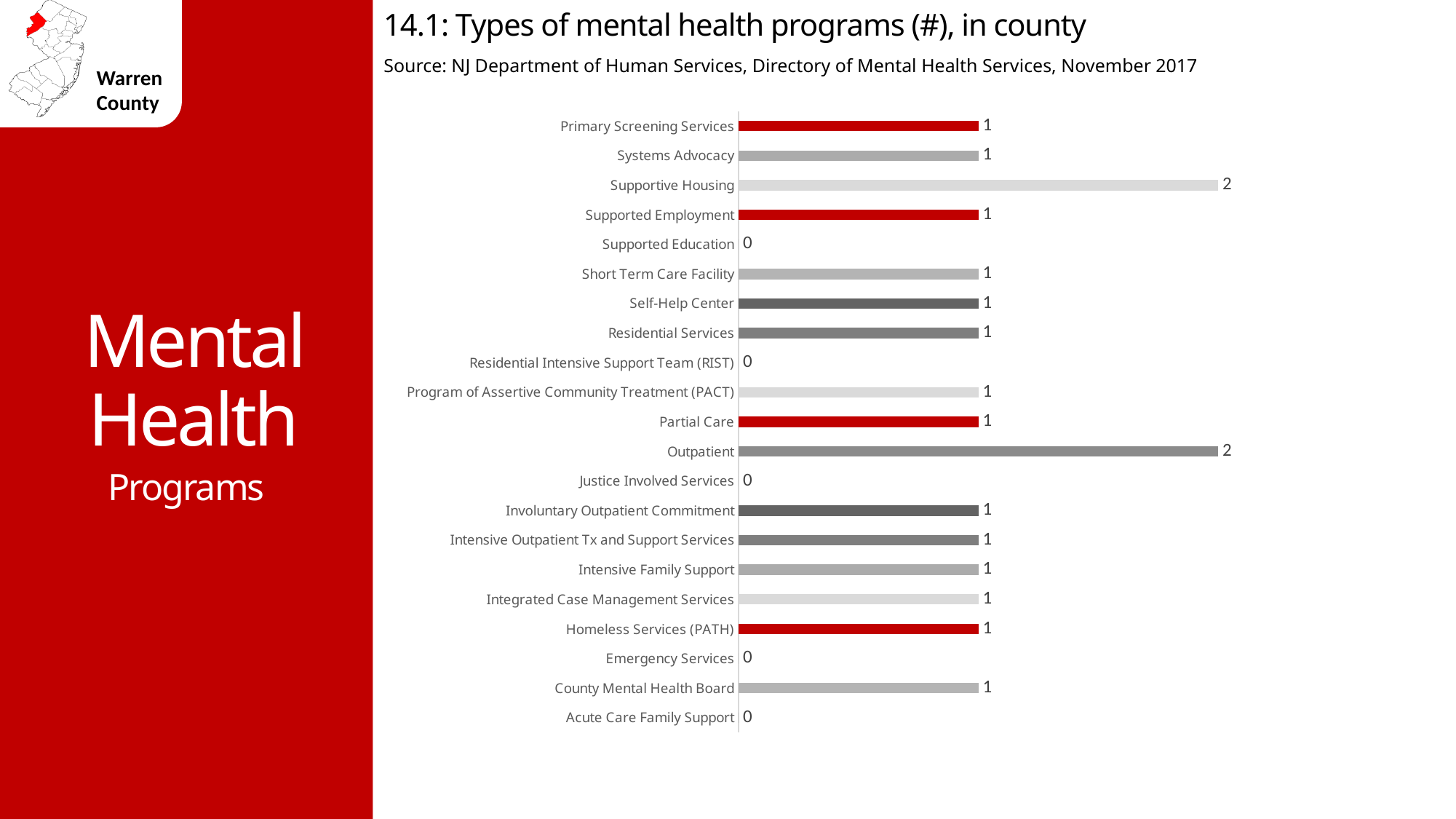
What is the title of the chart? 14.1: Types of mental health programs (#), in county What is the value for Emergency Services? 0 What kind of chart is shown on the slide? Bar chart What is the source cited for the chart? NJ Department of Human Services, Directory of Mental Health Services, November 2017 Which is larger, the value for Outpatient or the value for Partial Care? Outpatient What is the value for Outpatient? 2 What is the difference between the value for Supportive Housing and the value for Supported Employment? 1 How many categories are shown in the chart? 21 How many categories have a value of 0? 5 What is the value for Homeless Services (PATH)? 1 What is the value for Residential Intensive Support Team (RIST)? 0 What is the value for Supportive Housing? 2